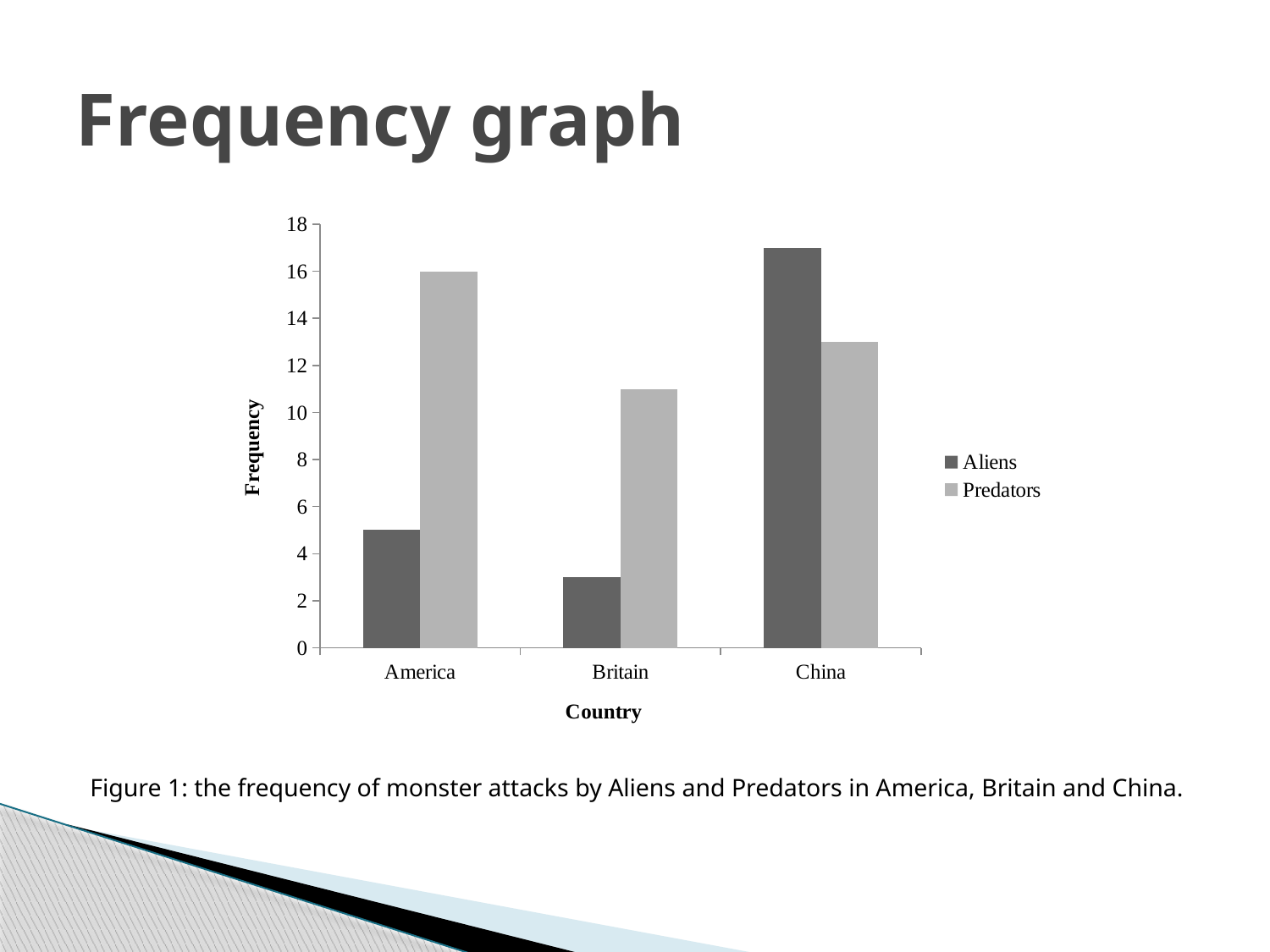
How many series does the legend list? 2 For China, which series is larger, Aliens or Predators? Aliens What is the Predators value for America? 16 How many countries are shown on the x axis? 3 For America, which series is larger, Aliens or Predators? Predators Is the Aliens value for China greater or less than 16? greater Which country has the highest Predators value? America Is the Predators value for Britain greater or less than 10? greater Which country has the lowest Predators value? Britain Is the Aliens value for Britain greater or less than 4? less Which country has the highest Aliens value? China Which country has the lowest Aliens value? Britain